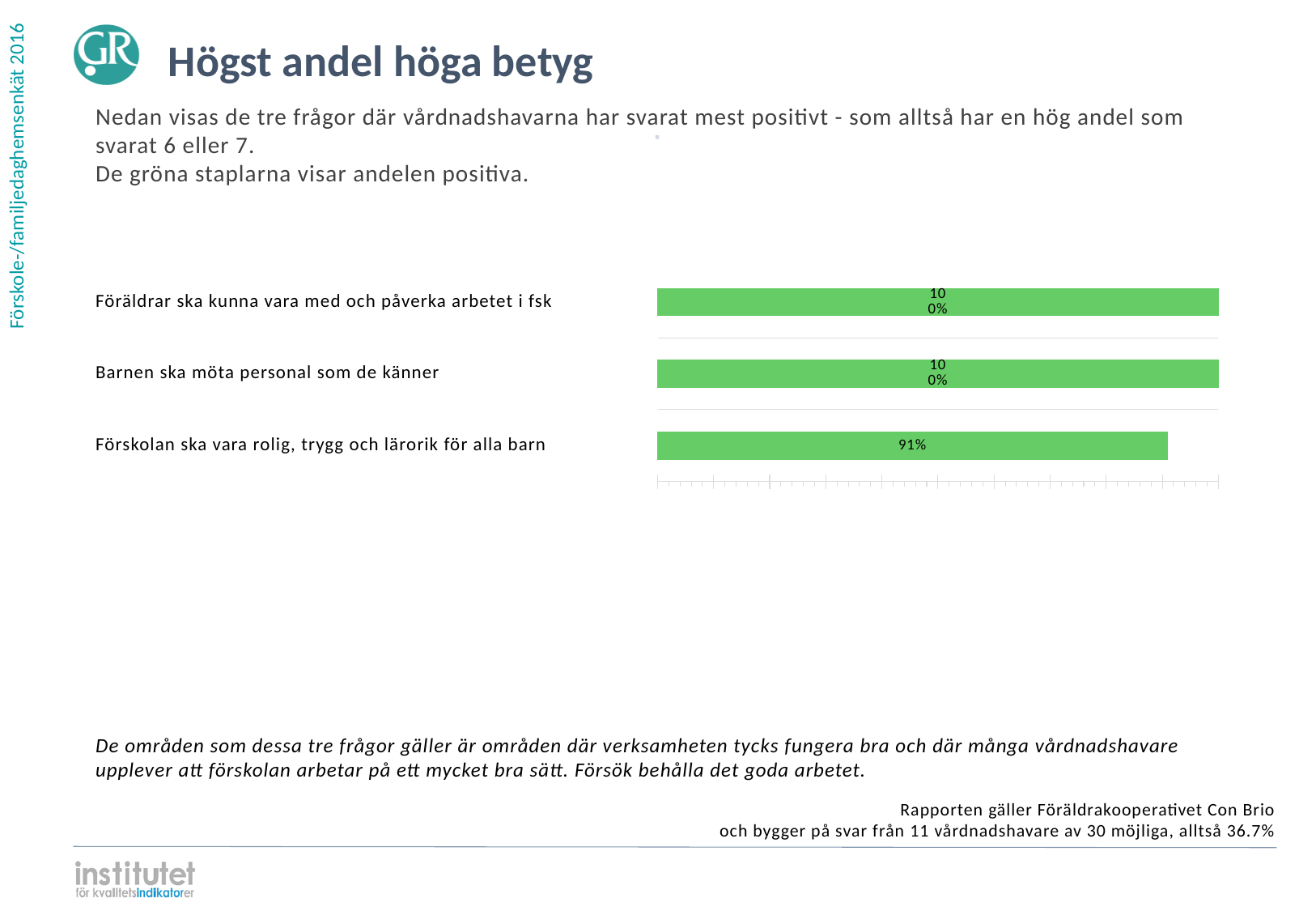
Which question has the lowest share of positive answers in the chart? Förskolan ska vara rolig, trygg och lärorik för alla barn What percentage is shown for "Barnen ska möta personal som de känner"? 100% What percentage is shown for "Förskolan ska vara rolig, trygg och lärorik för alla barn"? 91% What type of chart is shown on the slide? Bar chart Do "Föräldrar ska kunna vara med och påverka arbetet i fsk" and "Barnen ska möta personal som de känner" have the same value? Yes What is the title of the slide? Högst andel höga betyg What colour are the bars in the chart? Green What is the difference in percentage points between "Barnen ska möta personal som de känner" and "Förskolan ska vara rolig, trygg och lärorik för alla barn"? 9 percentage points How many questions (categories) are shown in the chart? 3 What percentage is shown for "Föräldrar ska kunna vara med och påverka arbetet i fsk"? 100% Which has a higher value: "Föräldrar ska kunna vara med och påverka arbetet i fsk" or "Förskolan ska vara rolig, trygg och lärorik för alla barn"? Föräldrar ska kunna vara med och påverka arbetet i fsk